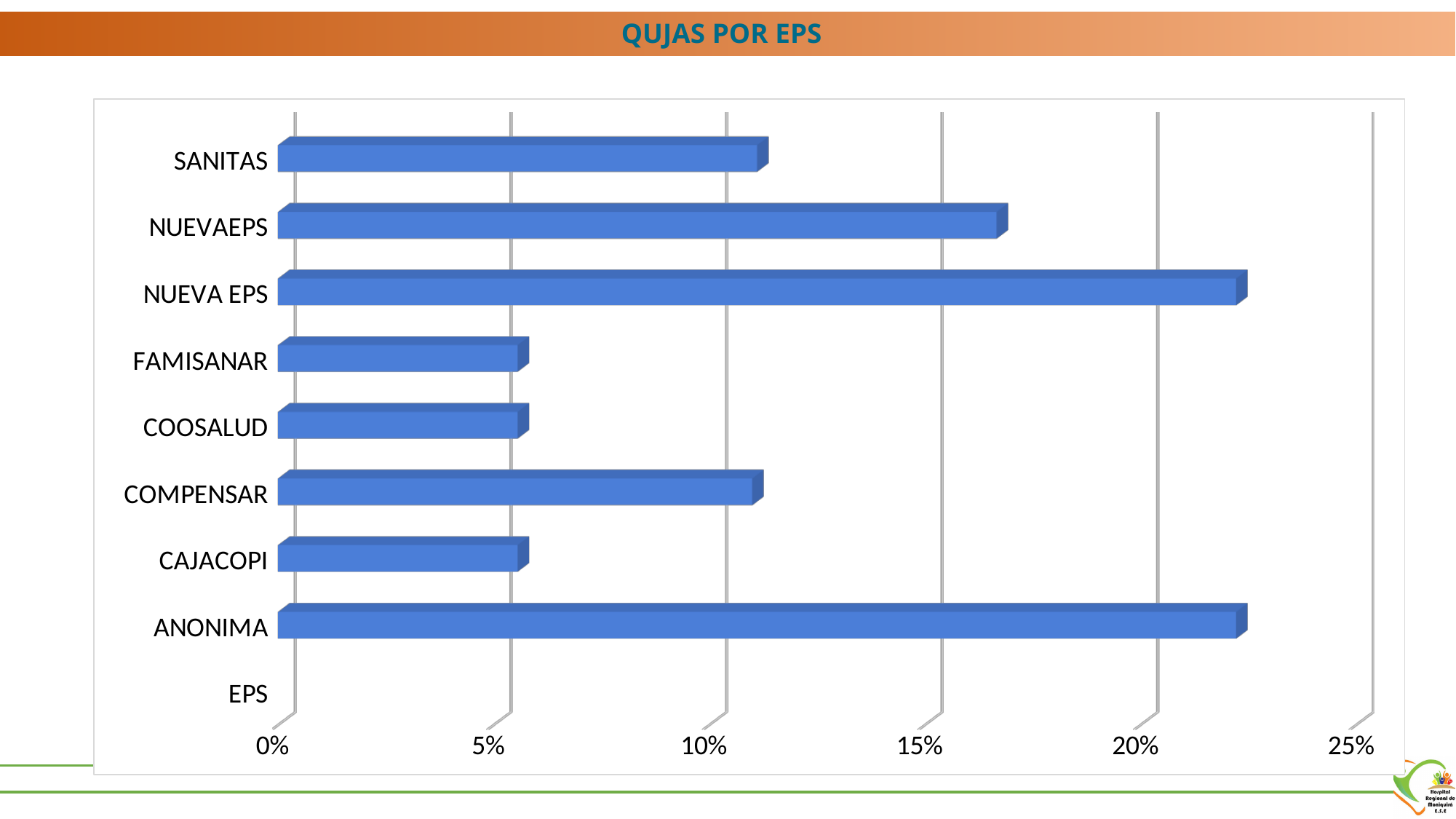
Is the value for CAJACOPI greater or less than 10%? less Which is larger, the value for NUEVAEPS or the value for SANITAS? NUEVAEPS Is the value for ANONIMA greater or less than 20%? greater Is the value for SANITAS greater or less than 10%? greater Which is larger, the value for COMPENSAR or the value for COOSALUD? COMPENSAR What kind of chart is shown on the slide? bar chart What is the highest value shown on the horizontal axis? 25% What is the title of the chart? QUJAS POR EPS How many bars are plotted in the chart? 8